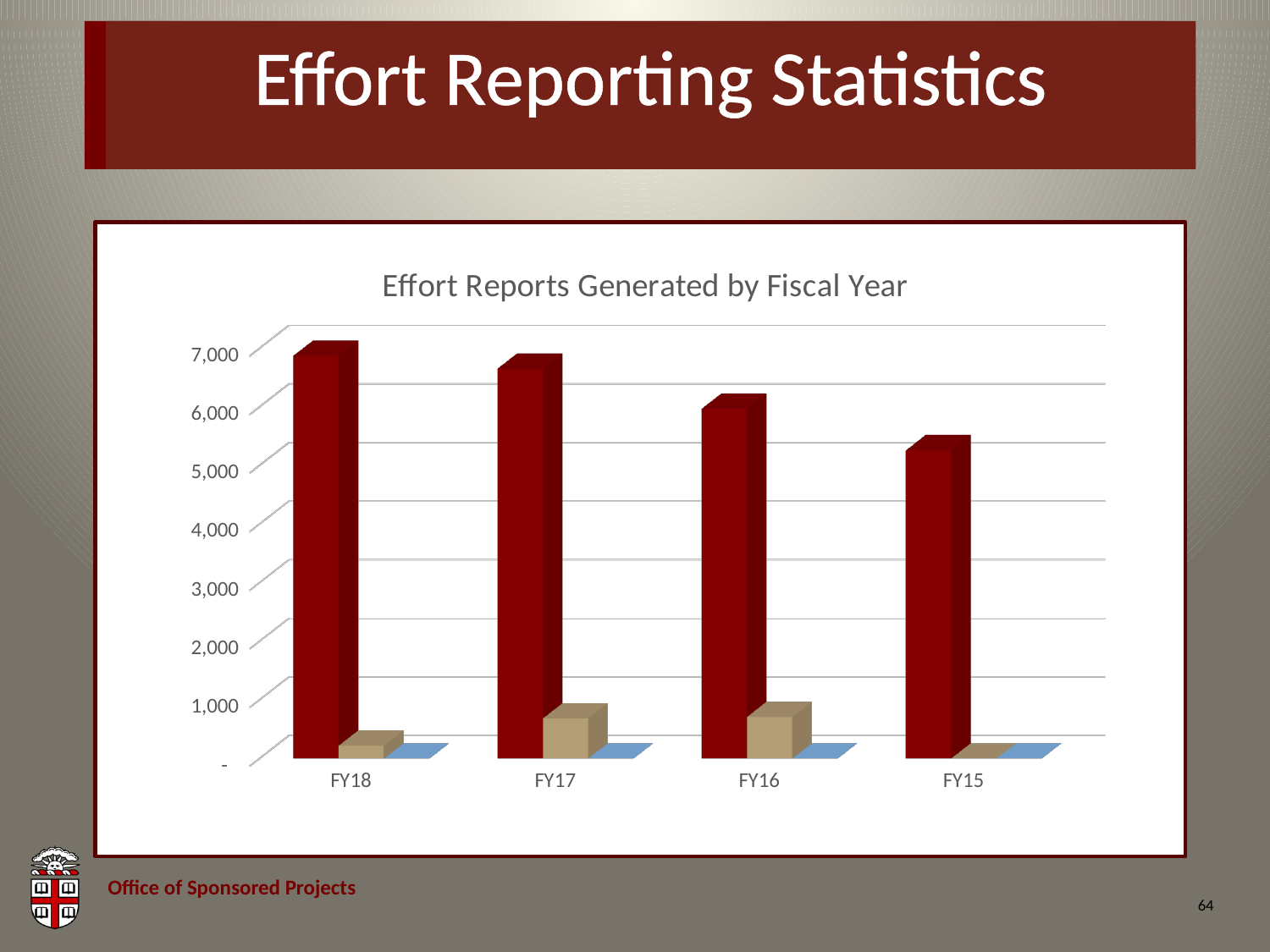
What is the highest value labelled on the vertical axis of the chart? 7,000 Is the dark red bar for FY16 greater or less than 5,000? greater Is the dark red bar for FY18 greater or less than 6,000? greater Is the tan bar for FY16 greater or less than 1,000? less What kind of chart is shown on the slide? Bar chart Which has the taller dark red bar, FY17 or FY15? FY17 How many fiscal years are shown on the x axis of the chart? 4 What is the title of the chart? Effort Reports Generated by Fiscal Year Which fiscal year has the shortest dark red bar? FY15 Which fiscal year has the tallest dark red bar? FY18 Do the dark red bars rise or fall moving from FY18 on the left to FY15 on the right? fall